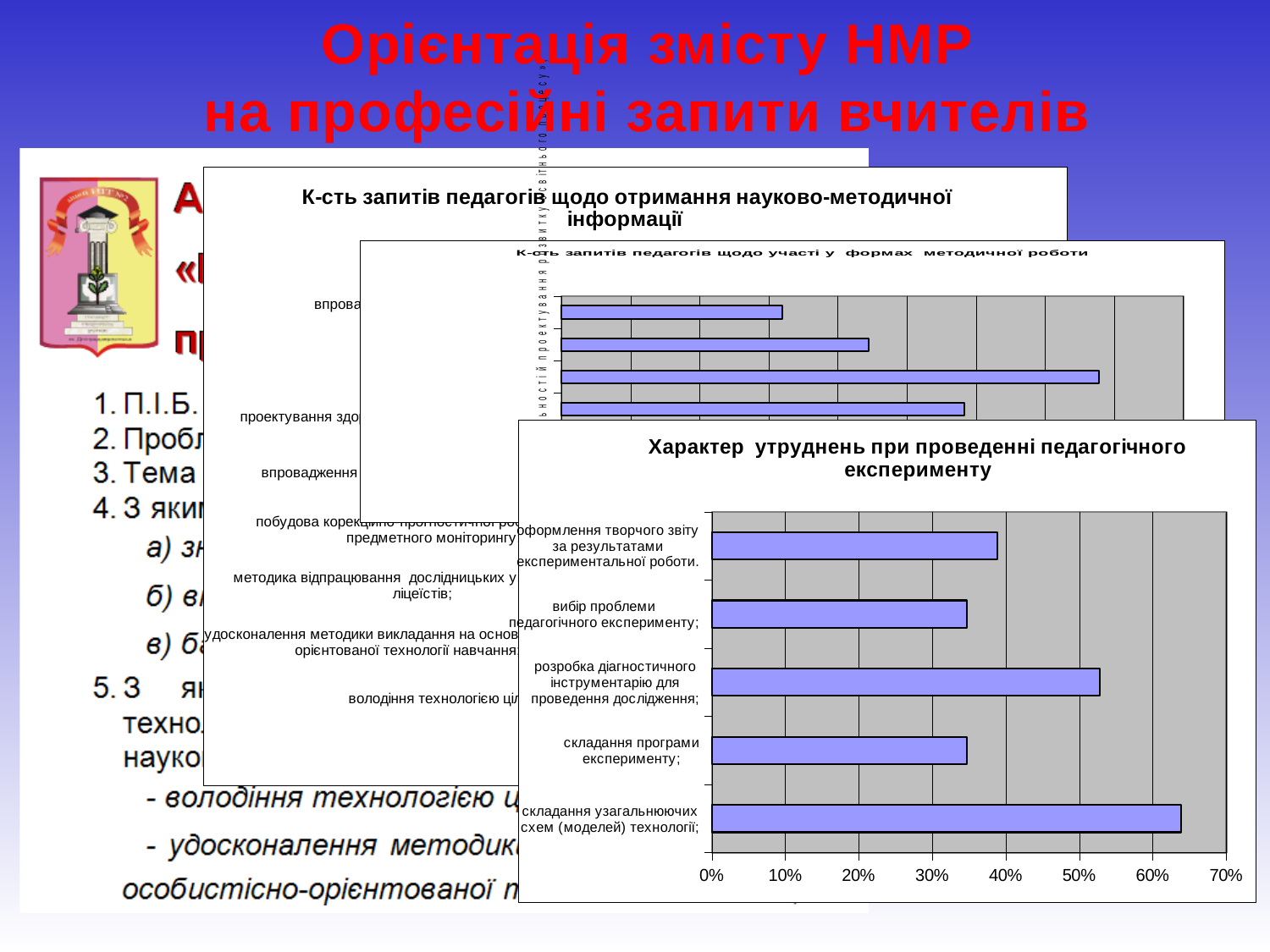
In the chart 'Характер утруднень при проведенні педагогічного експерименту', how many categories are plotted? 5 In the chart 'Характер утруднень при проведенні педагогічного експерименту', is the value for 'складання програми експерименту' greater or less than 30%? greater What is the title of the chart in the lower right of the slide? Характер утруднень при проведенні педагогічного експерименту In the chart 'Характер утруднень при проведенні педагогічного експерименту', is the value for 'оформлення творчого звіту за результатами експериментальної роботи' greater or less than 30%? greater In the chart 'Характер утруднень при проведенні педагогічного експерименту', which is larger: the value for 'розробка діагностичного інструментарію для проведення дослідження' or for 'оформлення творчого звіту за результатами експериментальної роботи'? розробка діагностичного інструментарію для проведення дослідження In the chart titled 'Характер утруднень при проведенні педагогічного експерименту', what kind of chart is shown? bar chart In the chart 'Характер утруднень при проведенні педагогічного експерименту', is the value for 'складання узагальнюючих схем (моделей) технології' greater or less than 60%? greater In the chart 'Характер утруднень при проведенні педагогічного експерименту', which category has the highest value? складання узагальнюючих схем (моделей) технології In the chart 'Характер утруднень при проведенні педагогічного експерименту', what is the maximum value shown on the horizontal axis? 70% In the chart 'Характер утруднень при проведенні педагогічного експерименту', which is larger: the value for 'складання узагальнюючих схем (моделей) технології' or for 'складання програми експерименту'? складання узагальнюючих схем (моделей) технології